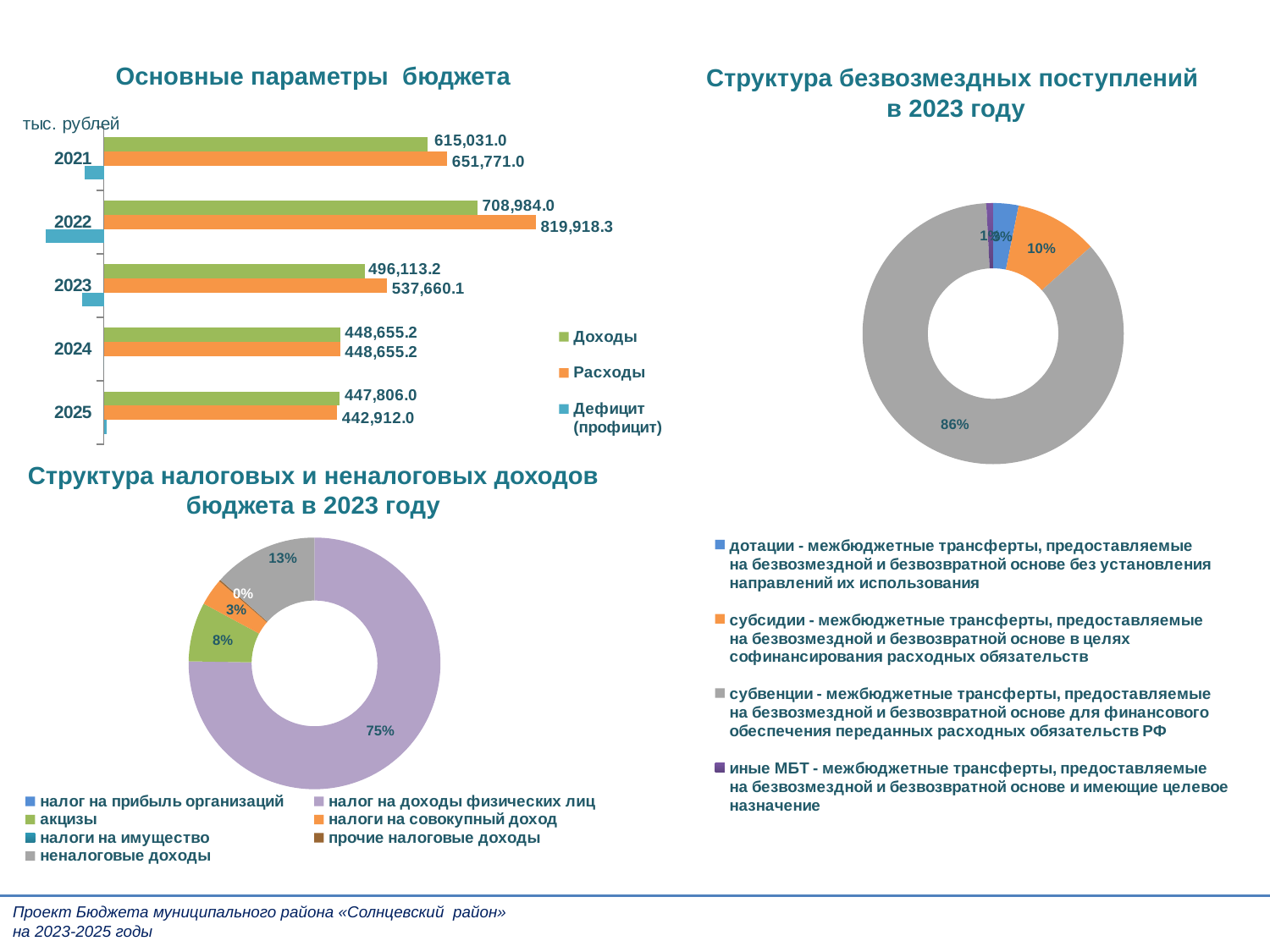
In the chart 'Основные параметры бюджета', which year has the highest Расходы? 2022 In the chart 'Основные параметры бюджета', which is larger for 2025: Доходы or Расходы? Доходы In the chart 'Структура безвозмездных поступлений в 2023 году', what share do субвенции have? 86% In the chart 'Основные параметры бюджета', how many years are shown? 5 In the chart 'Структура безвозмездных поступлений в 2023 году', what share do субсидии have? 10% What type of chart is 'Основные параметры бюджета'? Bar chart In the chart 'Структура налоговых и неналоговых доходов бюджета в 2023 году', what share does налог на доходы физических лиц have? 75% In the chart 'Основные параметры бюджета', what is the value of Доходы for 2022? 708,984.0 In the chart 'Основные параметры бюджета', what is the difference between Расходы and Доходы in 2022? 110,934.3 In the chart 'Основные параметры бюджета', how many series does the legend list? 3 In the chart 'Структура налоговых и неналоговых доходов бюджета в 2023 году', which category has the largest share? налог на доходы физических лиц In the chart 'Основные параметры бюджета', what is the value of Расходы for 2023? 537,660.1